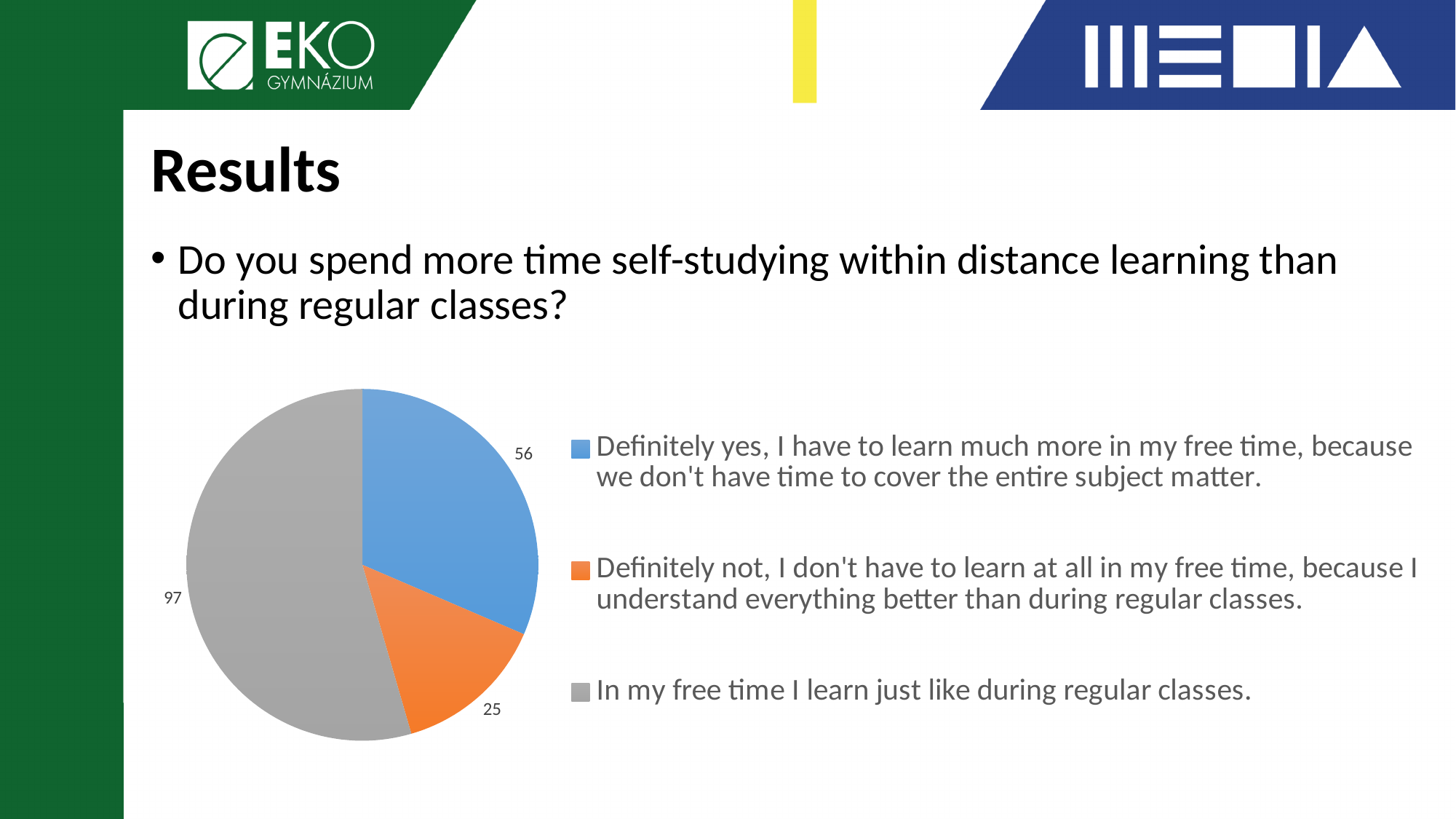
What is the difference between the 'In my free time I learn just like during regular classes.' slice and the 'Definitely yes' slice? 41 What is the value for the slice 'Definitely yes, I have to learn much more in my free time, because we don't have time to cover the entire subject matter.'? 56 What is the total of all three slices in the pie chart? 178 Which response has the largest slice in the pie chart? In my free time I learn just like during regular classes. What is the value for the slice 'Definitely not, I don't have to learn at all in my free time, because I understand everything better than during regular classes.'? 25 How many slices does the pie chart have? 3 Which is larger: the 'Definitely yes' slice or the 'Definitely not' slice? Definitely yes What is the difference between the 'Definitely yes' slice and the 'Definitely not' slice? 31 Which response has the smallest slice in the pie chart? Definitely not, I don't have to learn at all in my free time, because I understand everything better than during regular classes. What colour is the slice for 'In my free time I learn just like during regular classes.'? Grey What is the value for the slice 'In my free time I learn just like during regular classes.'? 97 What type of chart is shown on the slide? Pie chart